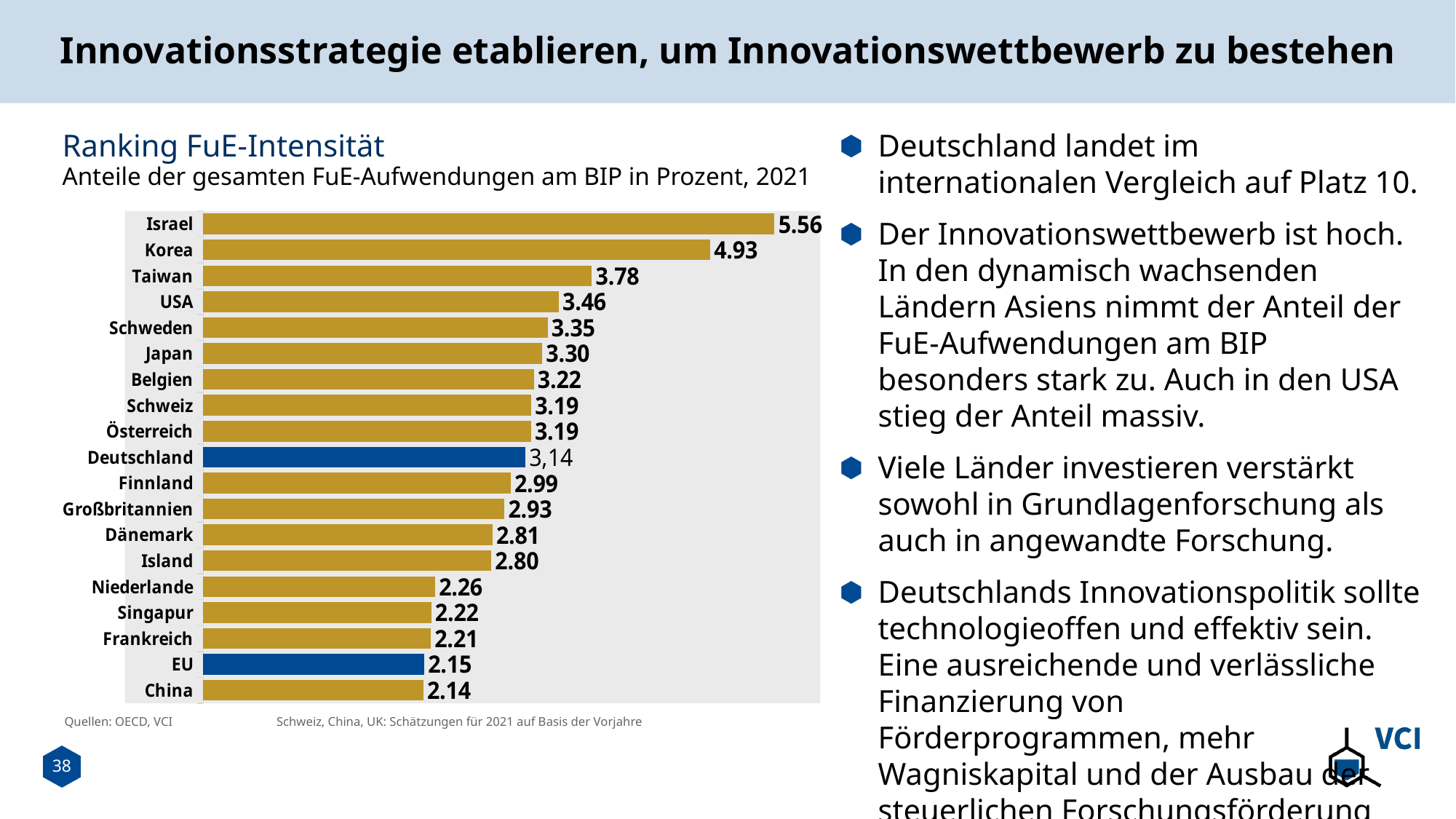
What is the difference between the values for USA and Japan? 0.16 Which category has the lowest value in the chart? China What is the value for Israel? 5.56 How many categories are shown in the chart? 19 Which has a larger value, Taiwan or USA? Taiwan What is the value for EU? 2.15 What is the value for Deutschland? 3,14 What is the difference between the values for Israel and Korea? 0.63 What kind of chart is shown on the slide? bar chart What is the title of the chart? Ranking FuE-Intensität Which country has the highest FuE-Intensität? Israel What is the value for Japan? 3.30